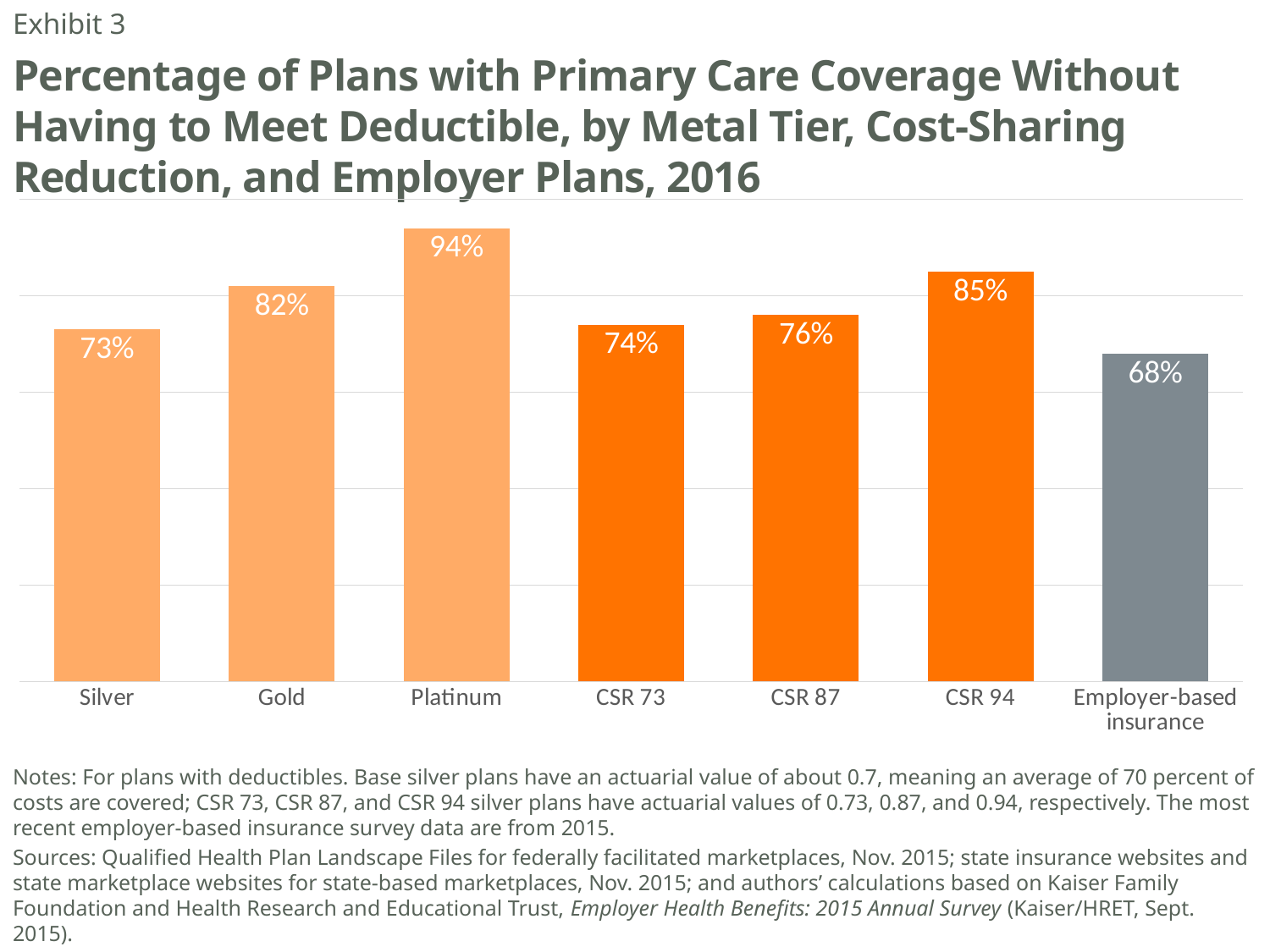
What kind of chart is shown on the slide? Bar chart Which category has the highest percentage of plans with primary care coverage without having to meet the deductible? Platinum What is the value shown for Employer-based insurance? 68% What is the value shown for CSR 87? 76% What is the difference in percentage points between CSR 94 and CSR 73? 11 Do the values rise or fall from Silver to Platinum? Rise Which is larger, the value for Silver or the value for Employer-based insurance? Silver Which is larger, the value for Gold or the value for CSR 94? CSR 94 Which category has the lowest percentage? Employer-based insurance What is the difference in percentage points between Platinum and Silver? 21 How many categories are shown on the x axis? 7 What percentage of Platinum plans cover primary care without having to meet the deductible? 94%